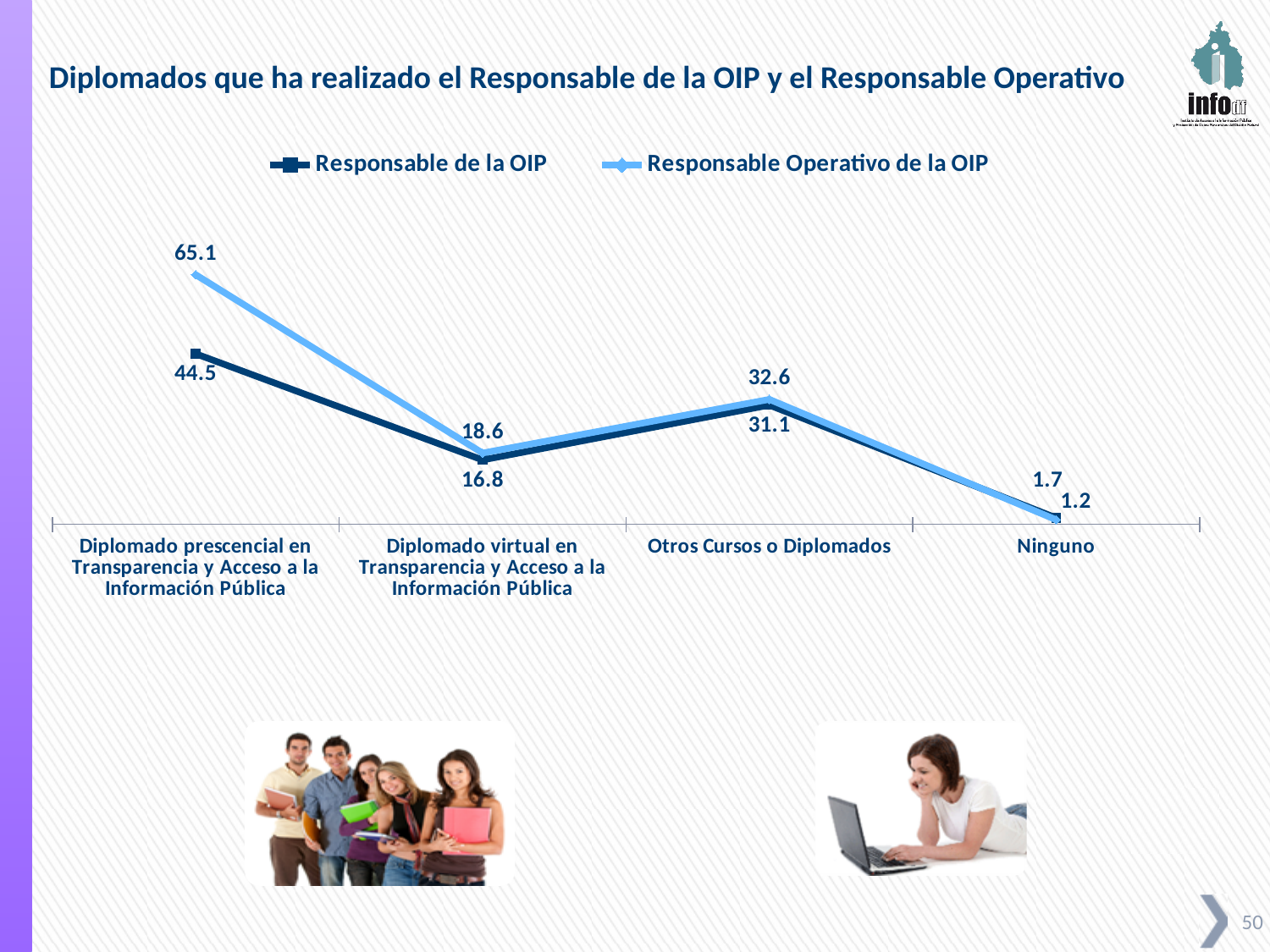
What is the difference between Responsable Operativo de la OIP and Responsable de la OIP in the category Diplomado prescencial en Transparencia y Acceso a la Información Pública? 20.6 What is the value for Responsable Operativo de la OIP in the category Ninguno? 1.2 What is the value for Responsable Operativo de la OIP in the category Diplomado prescencial en Transparencia y Acceso a la Información Pública? 65.1 How many categories are shown on the x axis? 4 What is the title of the chart? Diplomados que ha realizado el Responsable de la OIP y el Responsable Operativo What kind of chart is shown on the slide? Line chart In the category Otros Cursos o Diplomados, which series has the larger value? Responsable Operativo de la OIP What is the value for Responsable de la OIP in the category Diplomado virtual en Transparencia y Acceso a la Información Pública? 16.8 Which category has the lowest value for Responsable Operativo de la OIP? Ninguno Which category has the highest value for Responsable de la OIP? Diplomado prescencial en Transparencia y Acceso a la Información Pública What is the value for Responsable de la OIP in the category Otros Cursos o Diplomados? 31.1 How many series does the legend list? 2